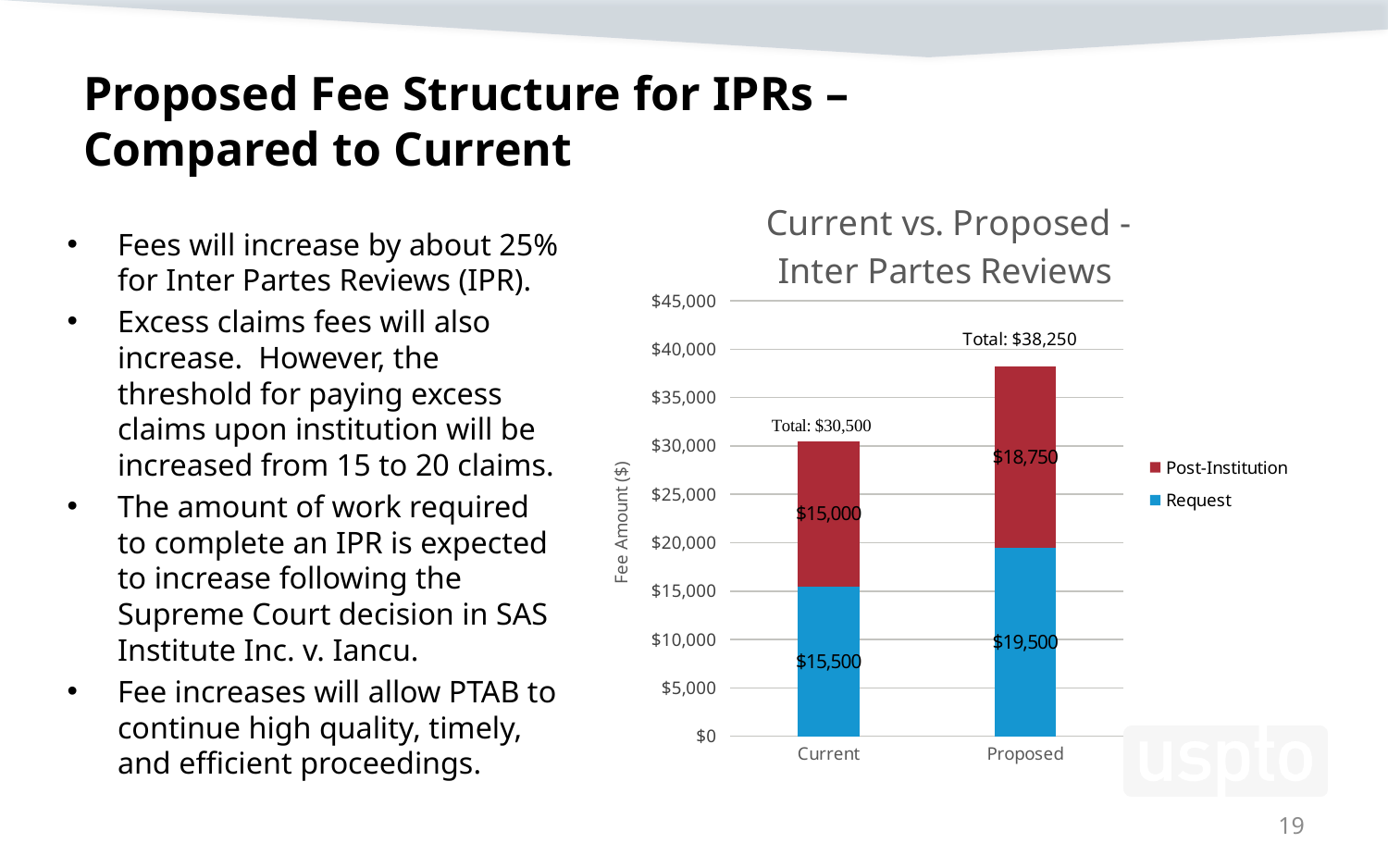
How many series does the legend list? 2 What is the Request fee for the Current category? $15,500 What is the Post-Institution fee for the Current category? $15,000 What is the total fee for the Proposed stacked bar? $38,250 What is the total fee for the Current stacked bar? $30,500 What kind of chart is shown on the slide? Stacked bar chart What is the difference between the Proposed and Current Post-Institution fees? $3,750 What is the Post-Institution fee for the Proposed category? $18,750 What is the Request fee for the Proposed category? $19,500 Which category has the higher total fee, Current or Proposed? Proposed What is the difference between the Proposed and Current Request fees? $4,000 What is the title of the chart? Current vs. Proposed - Inter Partes Reviews